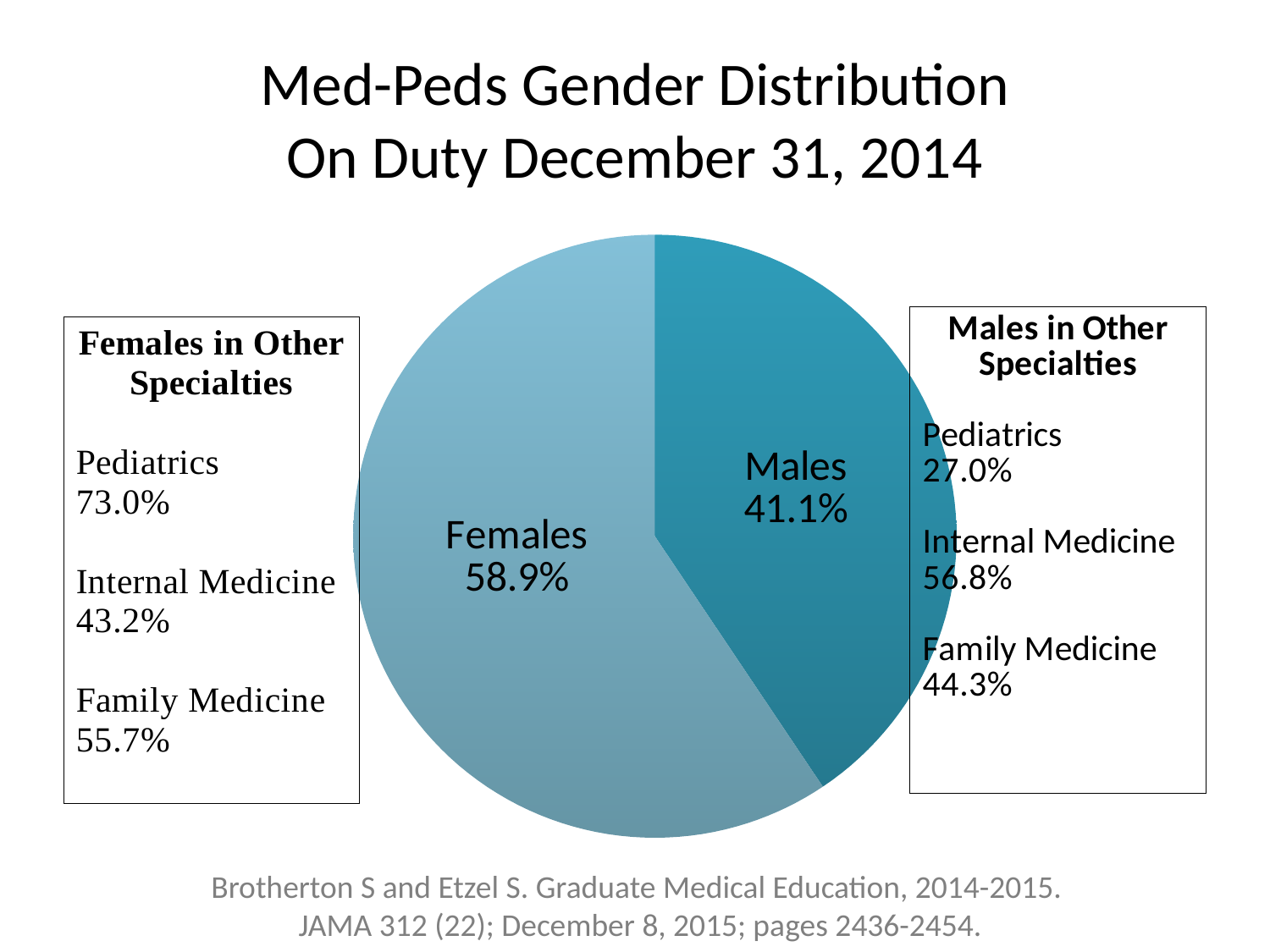
Which slice of the pie chart is the darker shade of blue? Males What is the difference in percentage points between the Females and Males slices? 17.8 What percentage of the pie chart is Males? 41.1% What is the title of the chart on the slide? Med-Peds Gender Distribution On Duty December 31, 2014 Which is larger in the pie chart, Females or Males? Females Which slice of the pie chart is the largest? Females What kind of chart is shown on the slide? Pie chart What percentage of the pie chart is Females? 58.9% Which slice of the pie chart is the smallest? Males How many slices does the pie chart have? 2 Is the Females share of the pie chart greater or less than 50%? greater